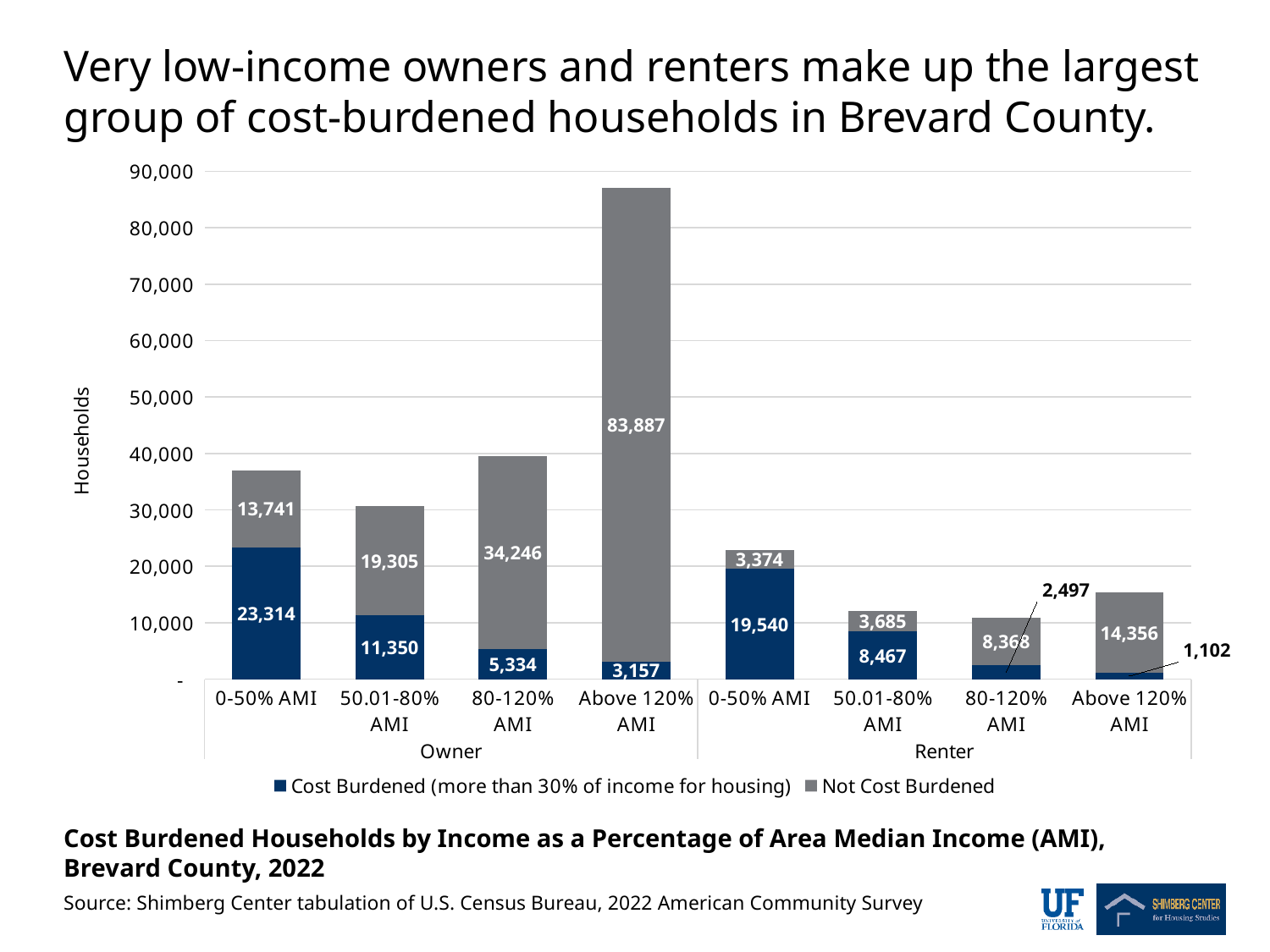
How many cost-burdened renter households are in the 80-120% AMI group? 2,497 What type of chart is shown on the slide? Stacked bar chart Which category has the largest number of not-cost-burdened households? Owner, Above 120% AMI What is the difference between cost-burdened owner households and cost-burdened renter households in the 0-50% AMI group? 3,774 What is the total number of households in the Renter 0-50% AMI bar? 22,914 How many series does the legend list? 2 Which category has the smallest number of cost-burdened households? Renter, Above 120% AMI How many income categories are shown on the x axis in total? 8 Which is larger: cost-burdened owner households at 50.01-80% AMI or cost-burdened renter households at 50.01-80% AMI? Owner (11,350) Is the total height of the Owner Above 120% AMI bar greater or less than 80,000? greater How many not-cost-burdened renter households are in the Above 120% AMI group? 14,356 How many cost-burdened owner households are in the 0-50% AMI group? 23,314